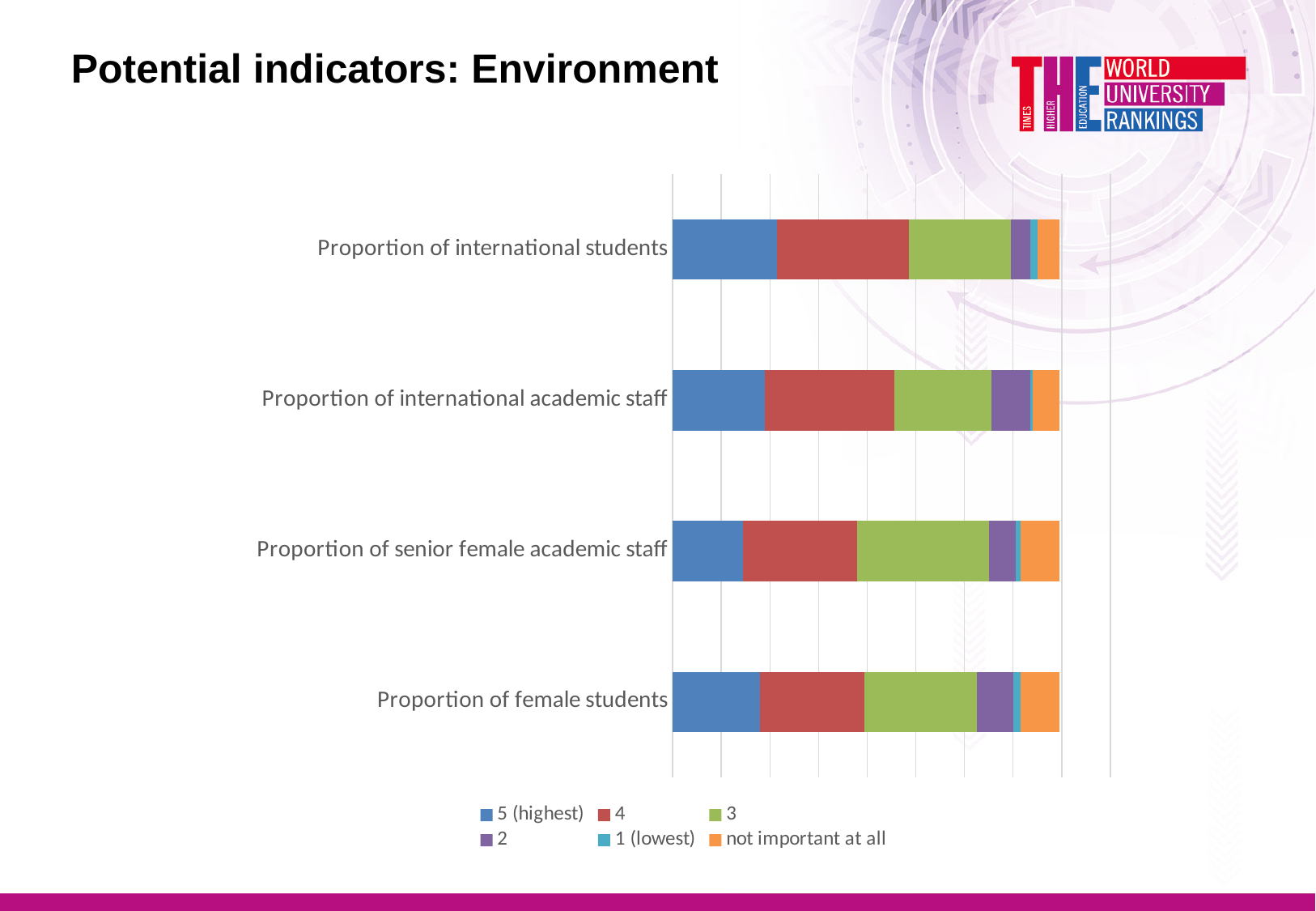
Which colour represents the '5 (highest)' rating in the chart? blue Which indicator has the smallest '5 (highest)' segment? Proportion of senior female academic staff Which series is shown in orange in the legend? not important at all How many categories (indicators) are plotted on the chart? 4 How many series does the chart's legend list? 6 Which is larger: the '3' segment for 'Proportion of senior female academic staff' or for 'Proportion of international academic staff'? Proportion of senior female academic staff Which is larger: the '2' segment for 'Proportion of international academic staff' or for 'Proportion of international students'? Proportion of international academic staff Which is larger: the '4' segment for 'Proportion of international students' or for 'Proportion of female students'? Proportion of international students Which indicator has the largest '3' segment? Proportion of senior female academic staff What kind of chart is shown on the slide? stacked bar chart